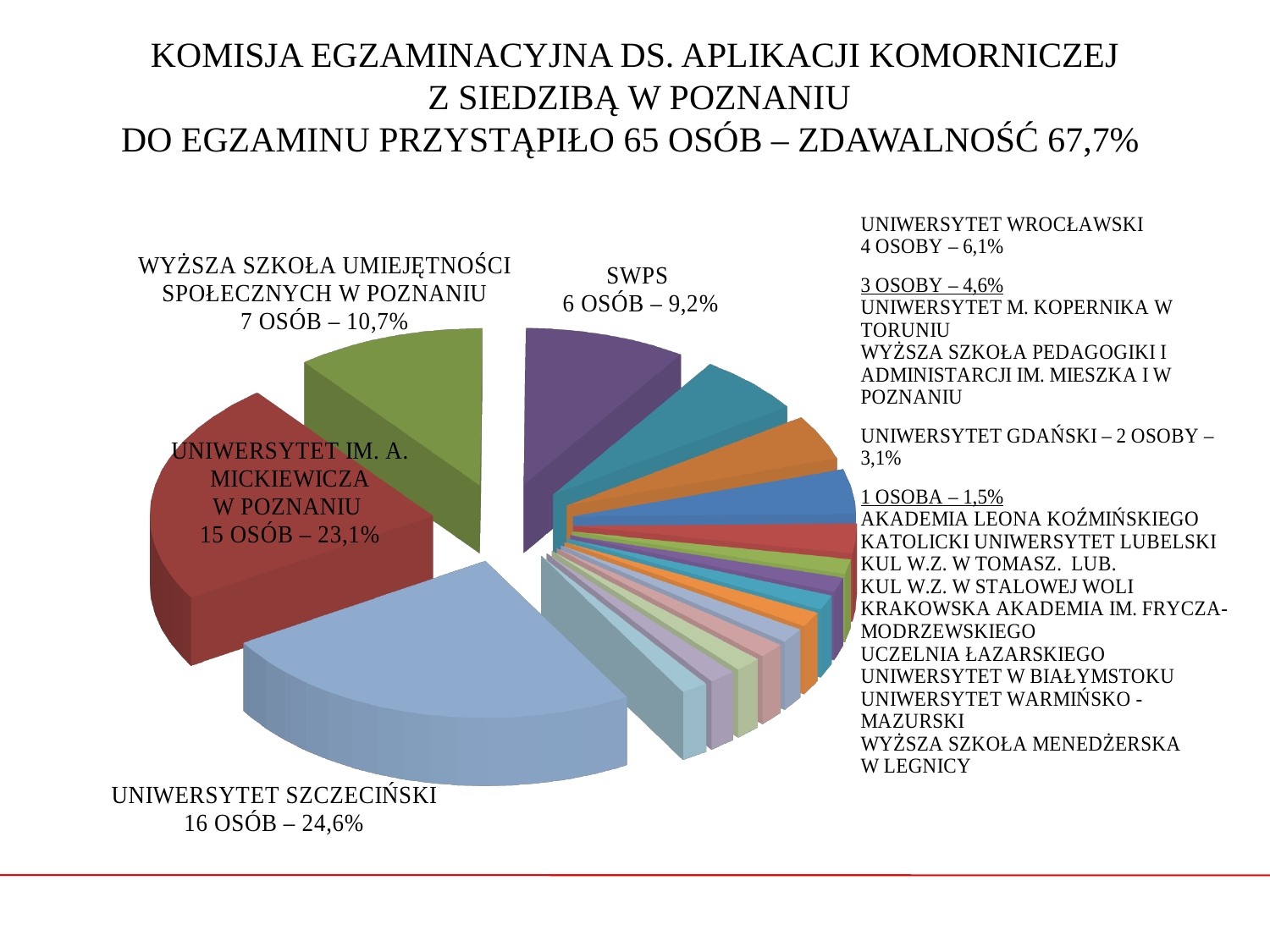
According to the slide title, how many people took the exam in total? 65 What share of the pie does UNIWERSYTET SZCZECIŃSKI represent? 24,6% How many more people came from UNIWERSYTET SZCZECIŃSKI than from UNIWERSYTET IM. A. MICKIEWICZA W POZNANIU? 1 What percentage is shown for UNIWERSYTET IM. A. MICKIEWICZA W POZNANIU? 23,1% Which institution has the largest slice of the pie? UNIWERSYTET SZCZECIŃSKI What percentage is shown for UNIWERSYTET WROCŁAWSKI? 6,1% What kind of chart is shown on the slide? pie chart How many institutions are listed with 1 OSOBA – 1,5%? 9 Which has the larger share: SWPS or WYŻSZA SZKOŁA UMIEJĘTNOŚCI SPOŁECZNYCH W POZNANIU? WYŻSZA SZKOŁA UMIEJĘTNOŚCI SPOŁECZNYCH W POZNANIU How many people came from UNIWERSYTET GDAŃSKI? 2 OSOBY What is the smallest share shown for any institution in the chart? 1,5% How many people from UNIWERSYTET SZCZECIŃSKI took the exam according to the chart? 16 OSÓB